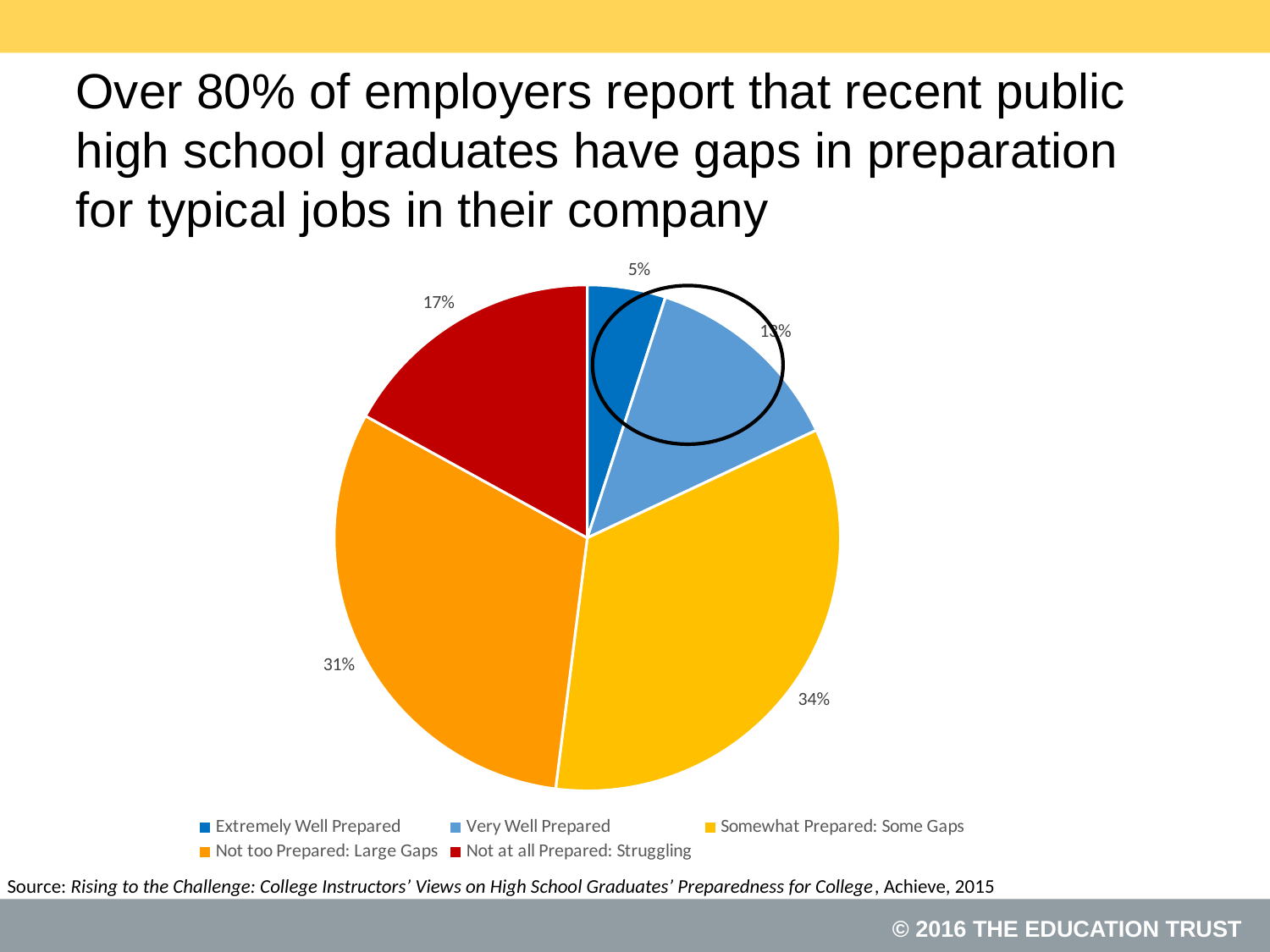
Which category has the smallest slice of the pie? Extremely Well Prepared What percentage of the pie is labelled "Not at all Prepared: Struggling"? 17% What percentage of the pie is labelled "Extremely Well Prepared"? 5% What percentage of the pie is labelled "Not too Prepared: Large Gaps"? 31% Which category has the largest slice of the pie? Somewhat Prepared: Some Gaps Which is larger: the slice for "Not at all Prepared: Struggling" or the slice for "Extremely Well Prepared"? Not at all Prepared: Struggling What percentage of the pie is labelled "Somewhat Prepared: Some Gaps"? 34% How many categories does the pie chart show? 5 What type of chart is shown on the slide? Pie chart What is the difference in percentage points between "Somewhat Prepared: Some Gaps" and "Not too Prepared: Large Gaps"? 3 percentage points What is the difference in percentage points between "Not too Prepared: Large Gaps" and "Not at all Prepared: Struggling"? 14 percentage points What colour is the slice for "Not at all Prepared: Struggling"? Red